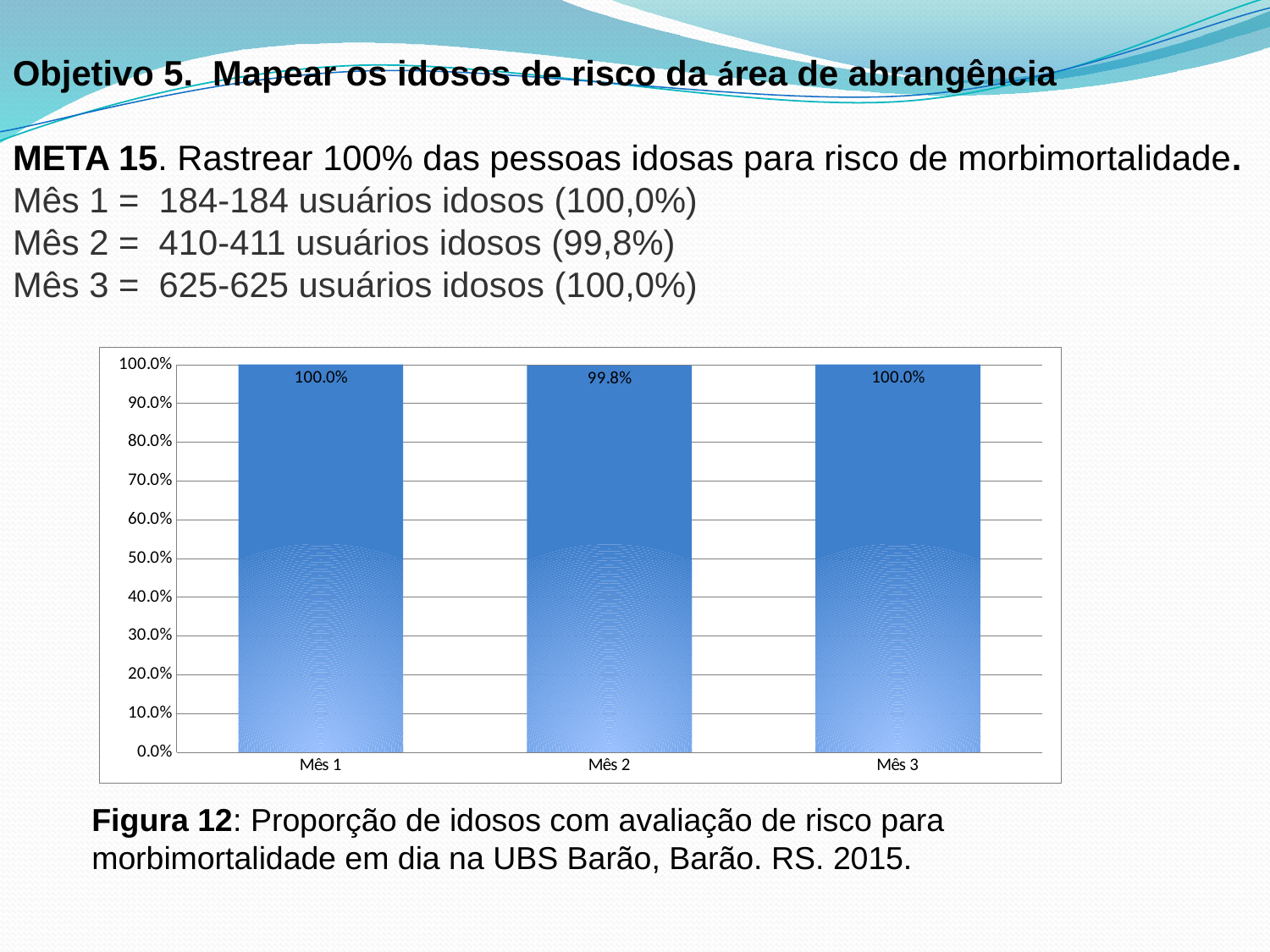
Is the value for Mês 2 greater or less than 50.0%? greater What figure number is given in the caption below the chart? Figura 12 What kind of chart is shown on the slide? bar chart What is the value shown for Mês 3? 100.0% How many categories are shown on the x axis of the chart? 3 What is the highest tick value shown on the y axis of the chart? 100.0% What is the difference between the values for Mês 1 and Mês 2? 0.2% What is the value shown for Mês 2? 99.8% What is the value shown for Mês 1? 100.0% Which is larger, the value for Mês 2 or the value for Mês 3? Mês 3 Which month has the lowest value in the chart? Mês 2